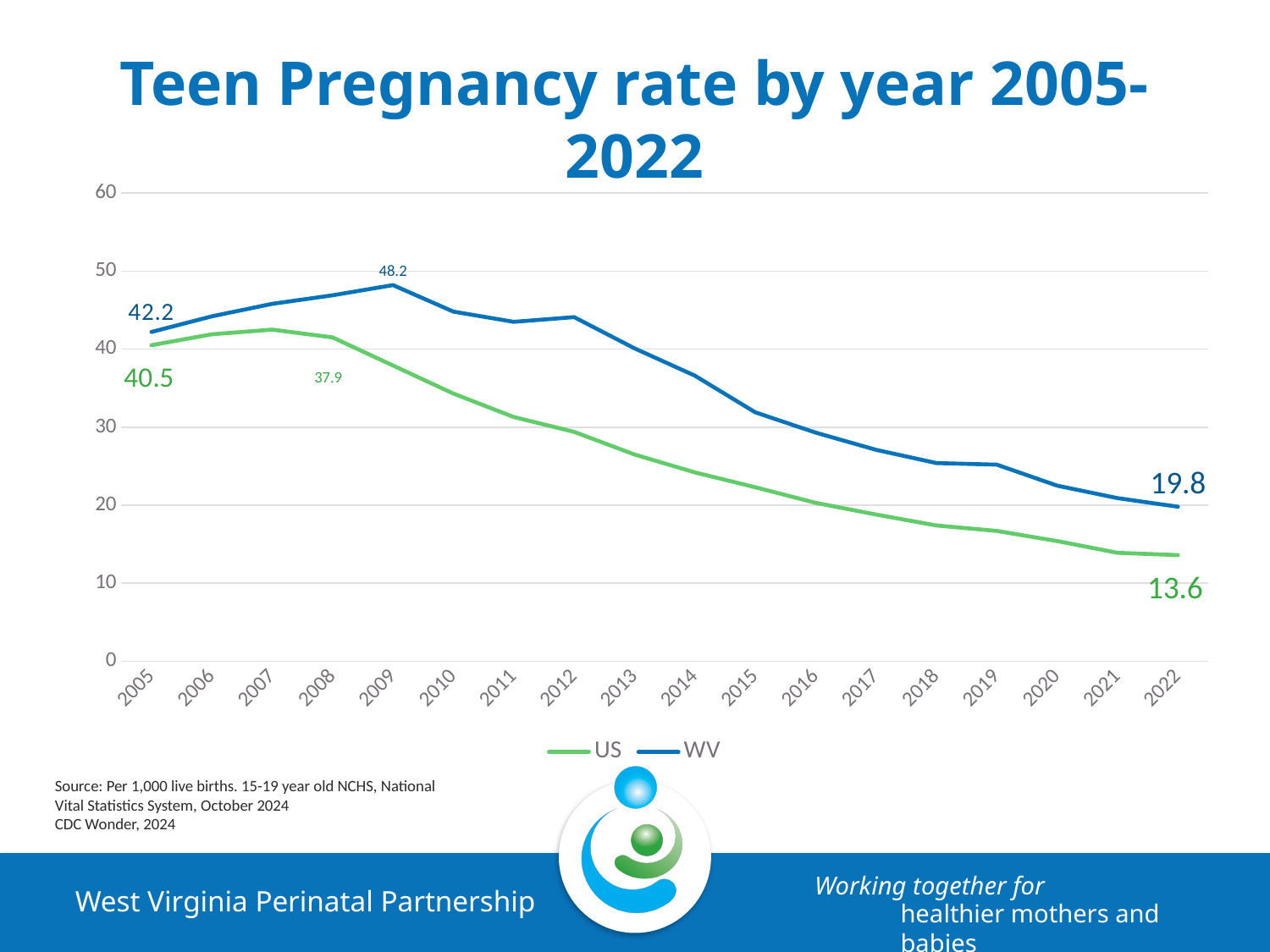
What is the WV teen pregnancy rate in 2005? 42.2 In which year does the WV series reach its highest value? 2009 What is the US teen pregnancy rate in 2022? 13.6 Is the WV value for 2018 greater or less than 20? greater In 2022, which series has the higher rate, US or WV? WV What is the WV teen pregnancy rate in 2022? 19.8 By how much did the US rate fall from 2005 to 2022? 26.9 What is the WV teen pregnancy rate in 2009? 48.2 By how much did the WV rate fall from 2005 to 2022? 22.4 What is the US teen pregnancy rate in 2005? 40.5 How many series does the legend list? 2 What kind of chart is shown on the slide? line chart